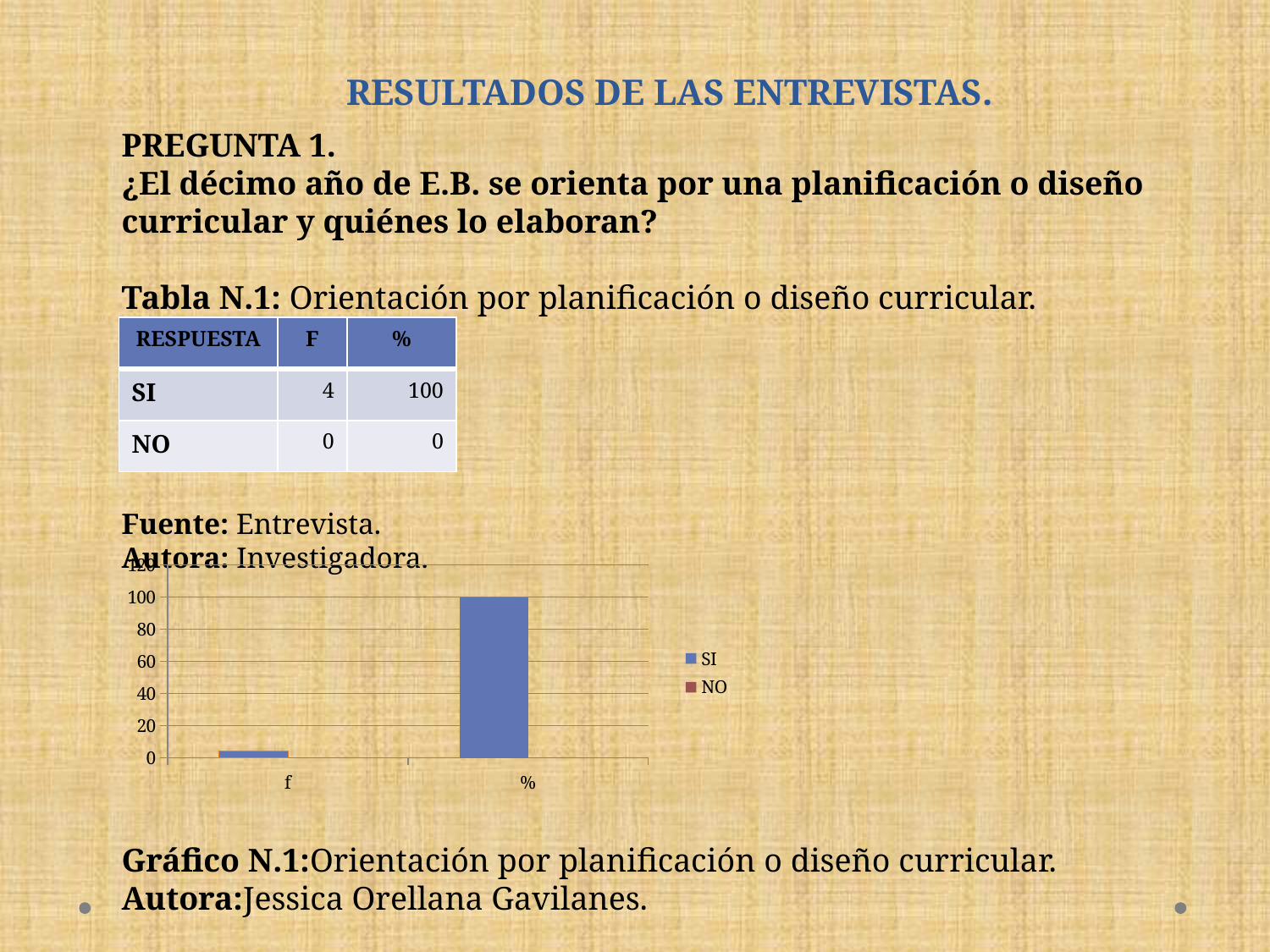
Is the value of the SI series for the % category greater or less than 80? greater Which is larger for the SI series: the value for f or the value for %? % For which category is the SI bar tallest? % What are the entries in the chart's legend? SI, NO Is the value of the SI series for the f category greater or less than 20? less What is the value of the SI series for the % category? 100 How many series does the chart's legend list? 2 How many categories are shown on the x axis of the chart? 2 Does the SI series rise or fall from the f category to the % category? rise What kind of chart is shown on the slide? bar chart What colour represents the SI series in the chart? blue What is the highest tick value shown on the chart's vertical axis? 120